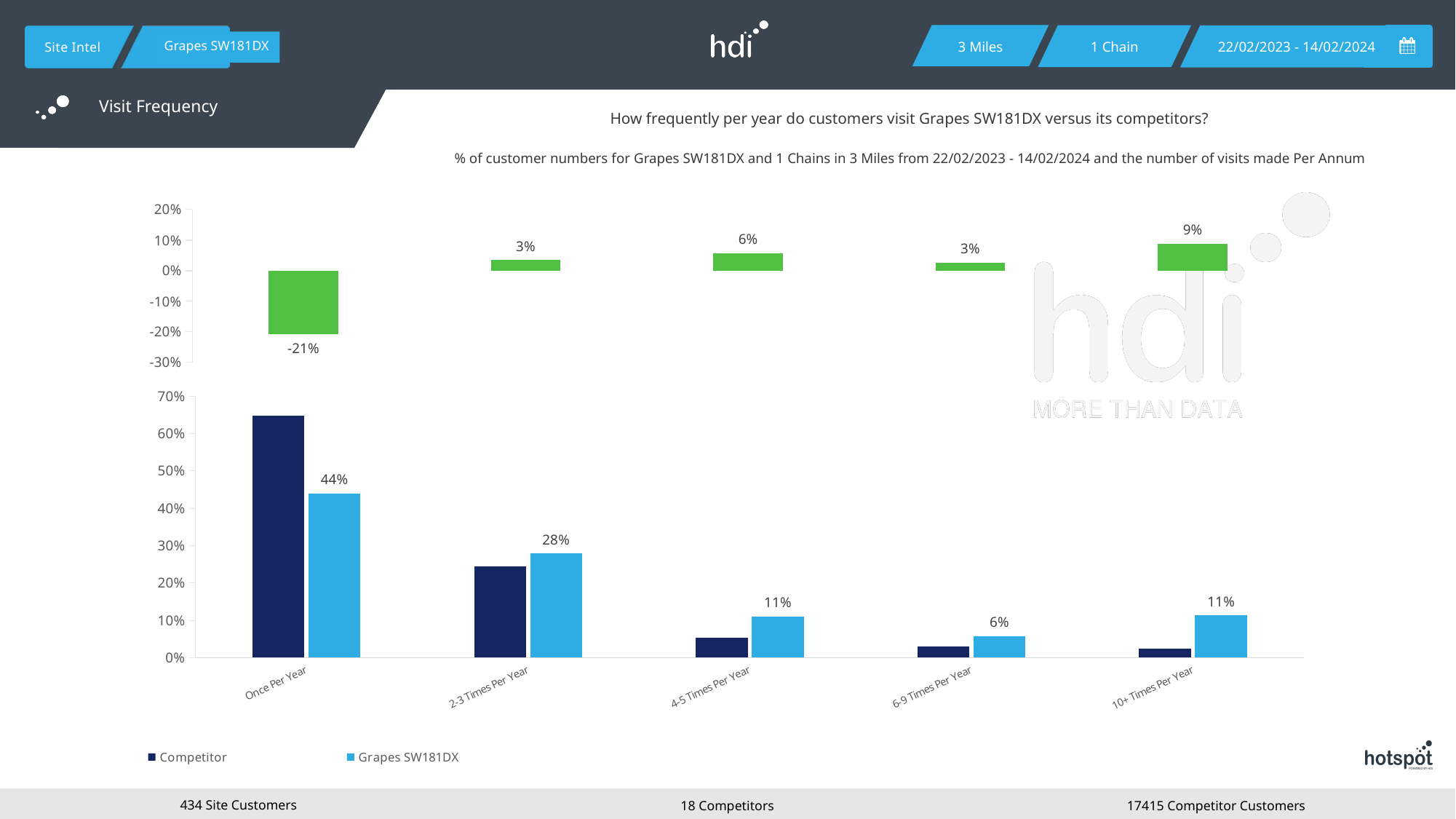
How many series does the legend of the bottom chart list? 2 In the bottom chart, what is the value for Grapes SW181DX in the Once Per Year category? 44% In the bottom chart, for Once Per Year, which series has the larger value: Competitor or Grapes SW181DX? Competitor In the top chart (green bars), what is the value for Once Per Year? -21% In the bottom chart, is the Competitor value for 2-3 Times Per Year greater or less than 30%? less In the top chart (green bars), which category has the highest value? 10+ Times Per Year In the bottom chart, what is the difference between the Grapes SW181DX values for Once Per Year and 2-3 Times Per Year? 16% In the top chart (green bars), what is the value for 10+ Times Per Year? 9% What kind of chart is the bottom chart? bar chart In the bottom chart, is the Competitor value for Once Per Year greater or less than 60%? greater How many visit-frequency categories are shown on the x axis of the bottom chart? 5 In the top chart (green bars), which category has the lowest value? Once Per Year